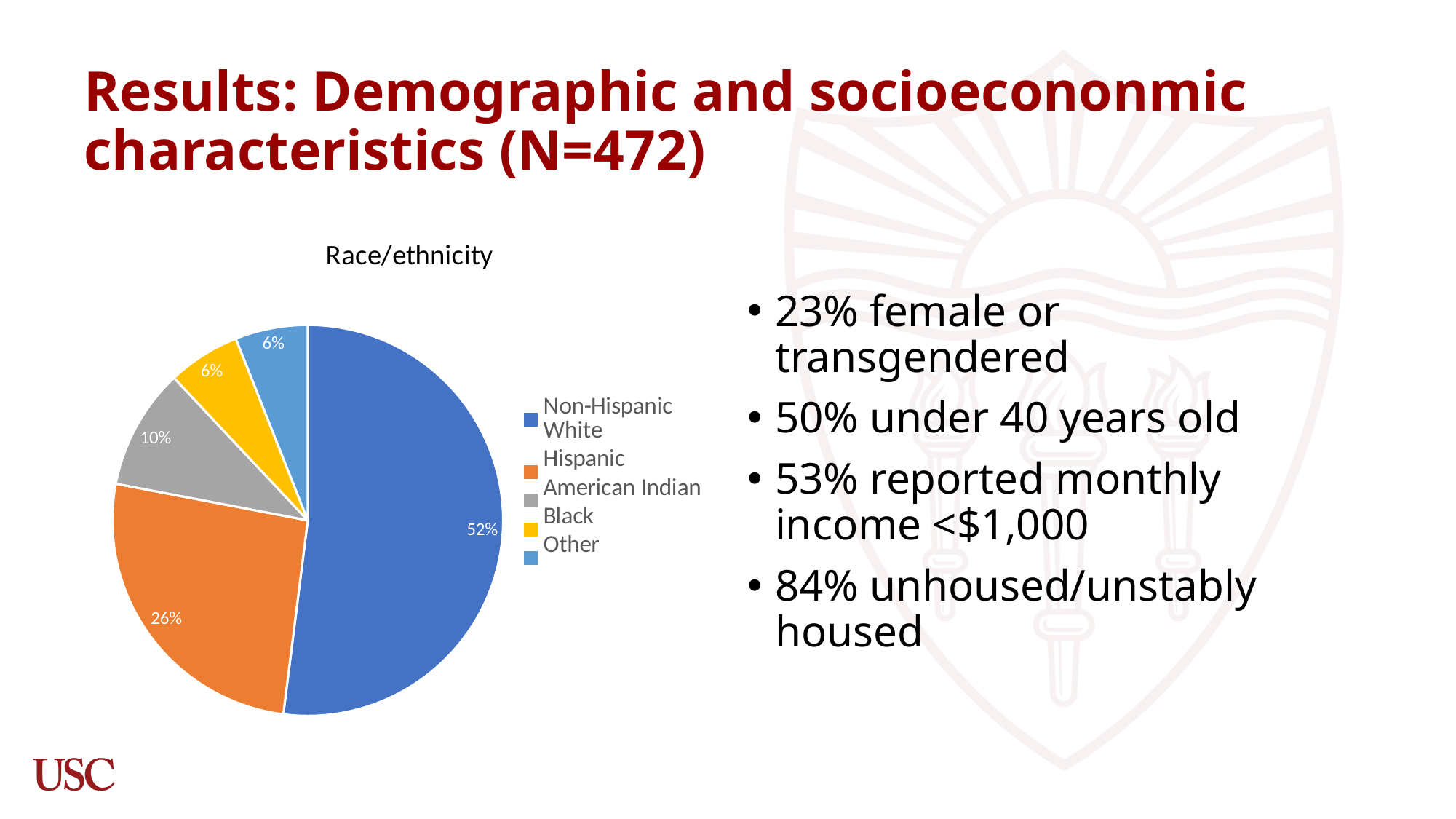
What type of chart is shown on the slide? Pie chart What is the title of the chart? Race/ethnicity How many categories does the legend list? 5 What share of the pie is Black? 6% What share of the pie is Non-Hispanic White? 52% What share of the pie is American Indian? 10% What colour is the Hispanic slice? Orange Which slice is larger, Hispanic or American Indian? Hispanic Which category has the largest slice of the pie? Non-Hispanic White What is the combined share of the Black and Other slices? 12% What is the difference in percentage points between the Non-Hispanic White and Hispanic slices? 26